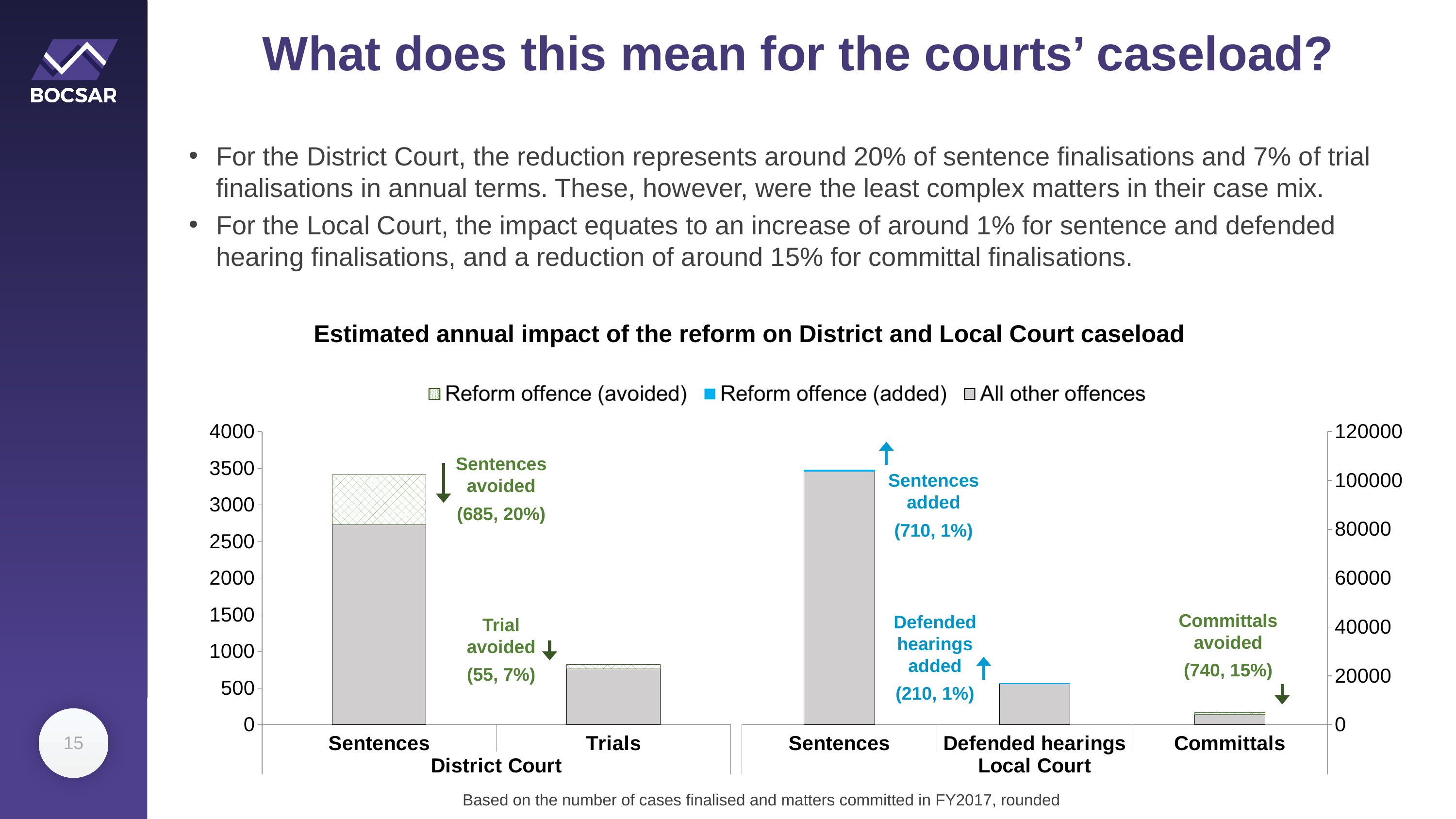
Which District Court bar is taller, Sentences or Trials? Sentences How many committals are avoided in the Local Court according to the chart annotation? 740 Which annotated reform impact has the largest count: sentences avoided, sentences added, or committals avoided? Committals avoided How many series does the chart legend list? 3 Is the total bar for District Court Sentences greater or less than 3000 on the left axis? greater According to the chart annotation, how many District Court sentences are avoided annually? 685 What kind of chart is shown on the slide? bar chart How many categories are shown along the x axis of the chart? 5 What is the title of the chart? Estimated annual impact of the reform on District and Local Court caseload How many sentences are added in the Local Court according to the chart annotation? 710 What percentage of District Court trial finalisations does the chart annotation say are avoided? 7% What is the difference between the number of District Court sentences avoided (685) and trials avoided (55)? 630